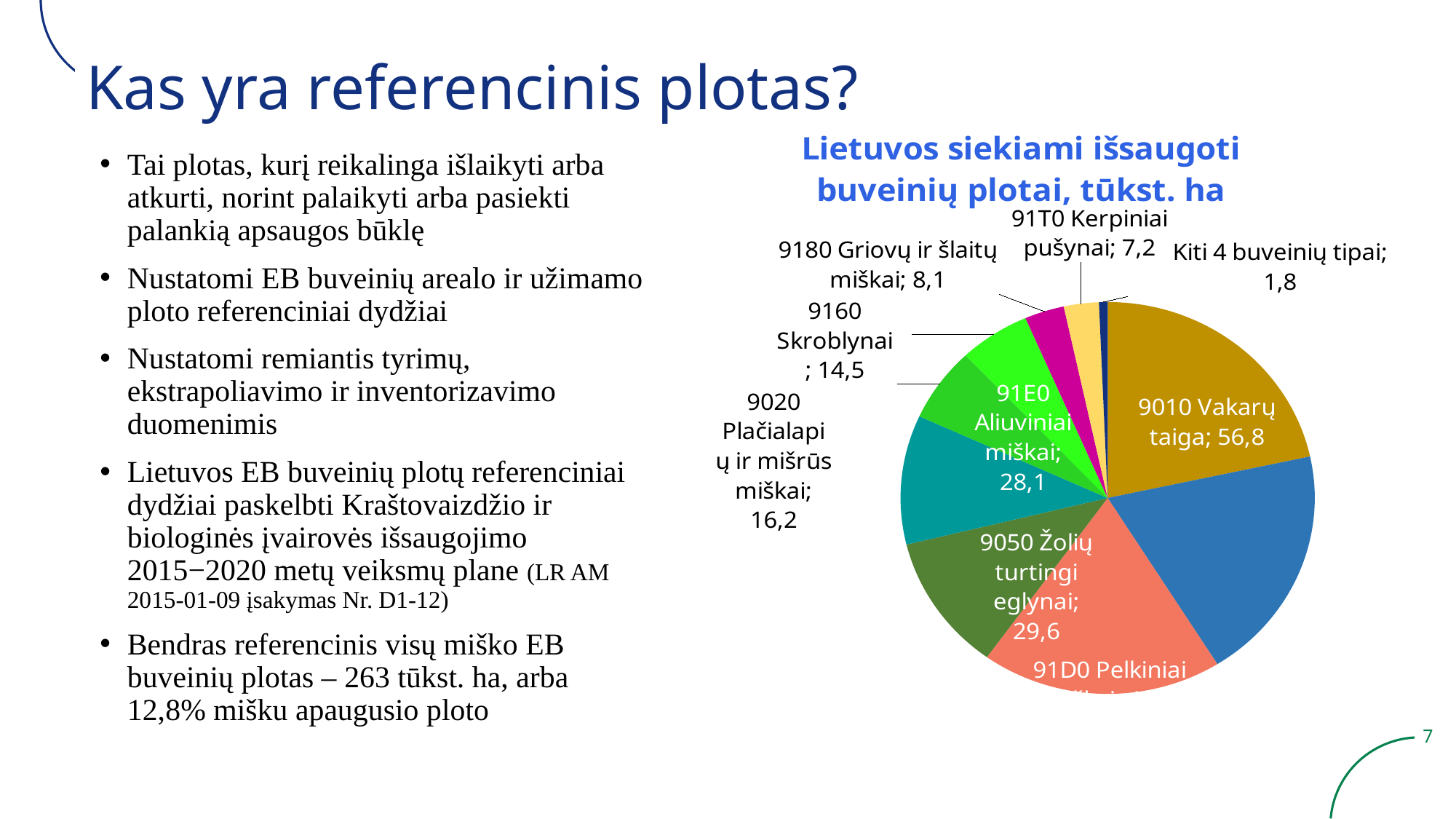
What is the value for 9050 Žolių turtingi eglynai? 29,6 What is the value for 9010 Vakarų taiga in the pie chart? 56,8 What is the difference between the values for 9010 Vakarų taiga and 9050 Žolių turtingi eglynai? 27,2 Which slice of the pie chart is the largest? 9010 Vakarų taiga Which slice of the pie chart is the smallest? Kiti 4 buveinių tipai What is the value for 91E0 Aliuviniai miškai? 28,1 What is the title of the pie chart? Lietuvos siekiami išsaugoti buveinių plotai, tūkst. ha What is the value for 9160 Skroblynai? 14,5 What is the value for 91T0 Kerpiniai pušynai? 7,2 Which is larger, the value for 9020 Plačialapių ir mišrūs miškai or for 9160 Skroblynai? 9020 Plačialapių ir mišrūs miškai How many slices does the pie chart have? 10 What kind of chart is shown on the slide? pie chart